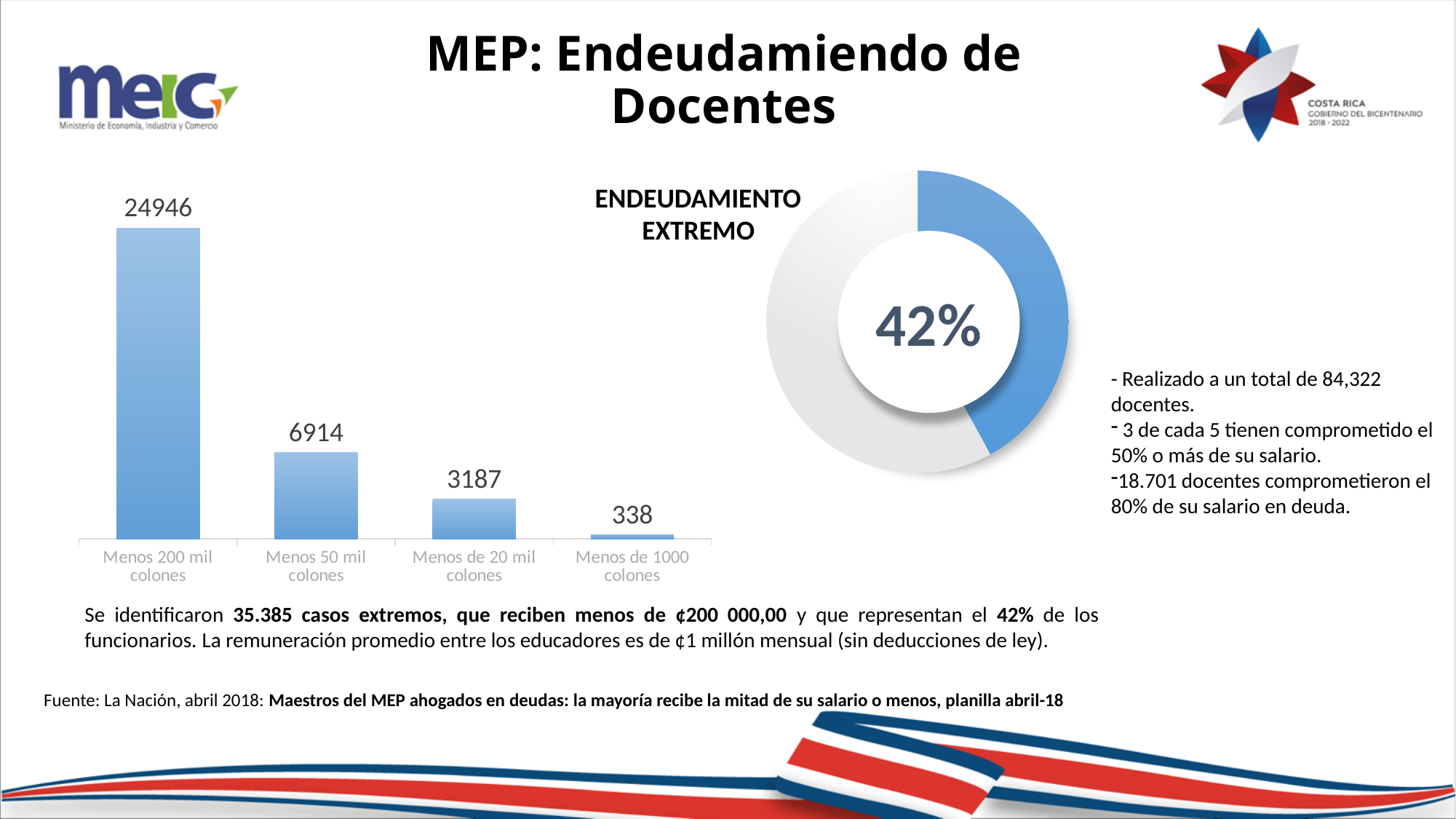
Do the values in the bar chart on the left rise or fall from left to right? Fall What kind of chart is the chart on the left of the slide? Bar chart In the 'ENDEUDAMIENTO EXTREMO' doughnut chart, what percentage is shown in the centre? 42% In the bar chart on the left, which category has the highest value? Menos 200 mil colones In the bar chart on the left, what is the value for 'Menos de 20 mil colones'? 3187 In the bar chart on the left, which is larger: the value for 'Menos 50 mil colones' or 'Menos de 20 mil colones'? Menos 50 mil colones In the bar chart on the left, which category has the lowest value? Menos de 1000 colones In the bar chart on the left, what is the value for 'Menos 200 mil colones'? 24946 In the bar chart on the left, what is the difference between the values for 'Menos 200 mil colones' and 'Menos 50 mil colones'? 18032 How many categories are shown in the bar chart on the left? 4 In the bar chart on the left, what is the value for 'Menos 50 mil colones'? 6914 In the bar chart on the left, what is the value for 'Menos de 1000 colones'? 338